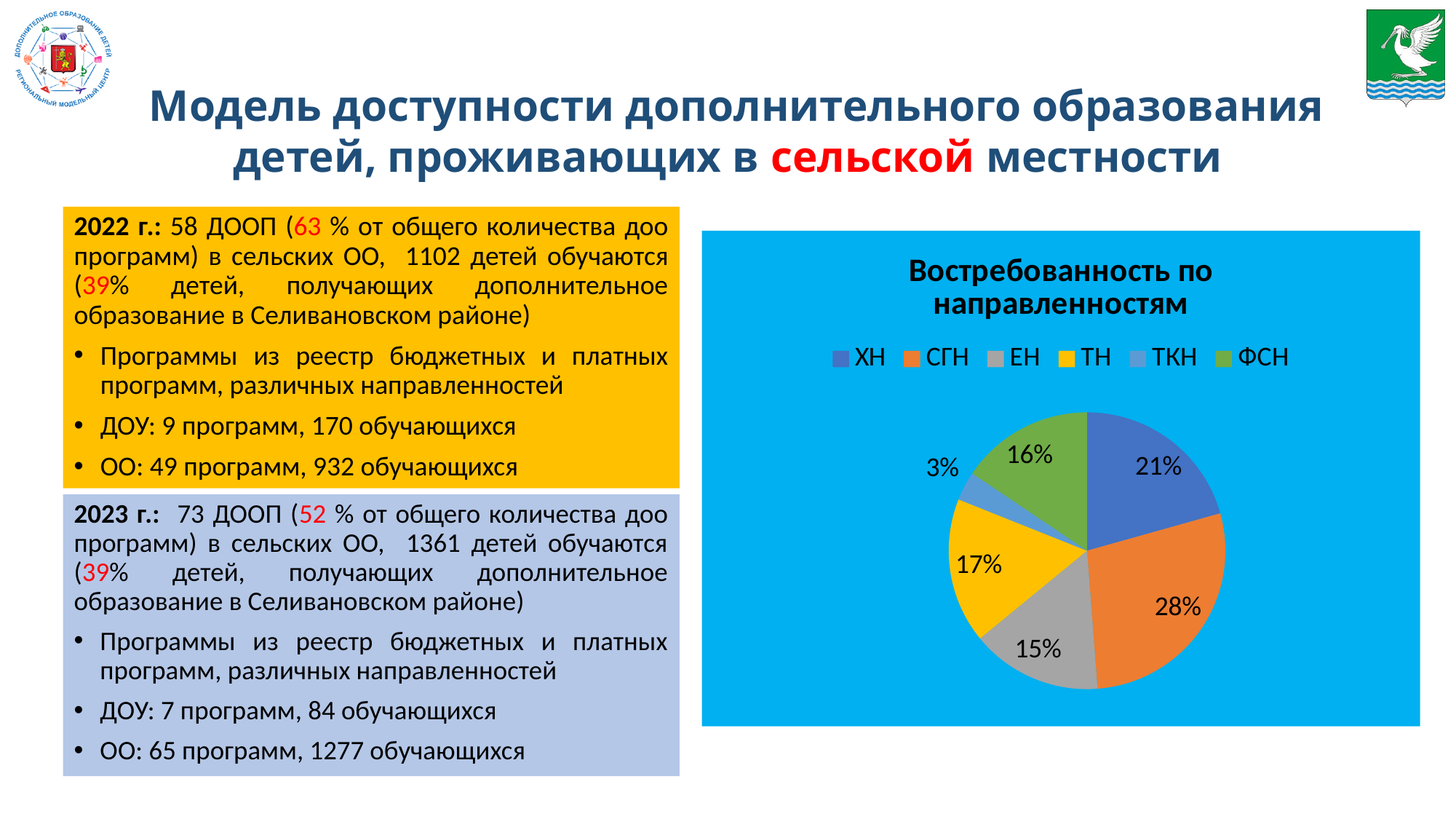
What share of the pie does ТКН have? 3% Which category has the smallest slice of the pie? ТКН Which colour represents ТН in the pie chart? yellow What is the title of the pie chart? Востребованность по направленностям What kind of chart is shown on the slide? pie chart How many categories does the pie chart legend list? 6 What is the difference in percentage points between the СГН slice and the ЕН slice? 13 What share of the pie does ФСН have? 16% What share of the pie does СГН have? 28% Which category has the largest slice of the pie? СГН Which slice is larger, ТН or ЕН? ТН What share of the pie does ХН have? 21%